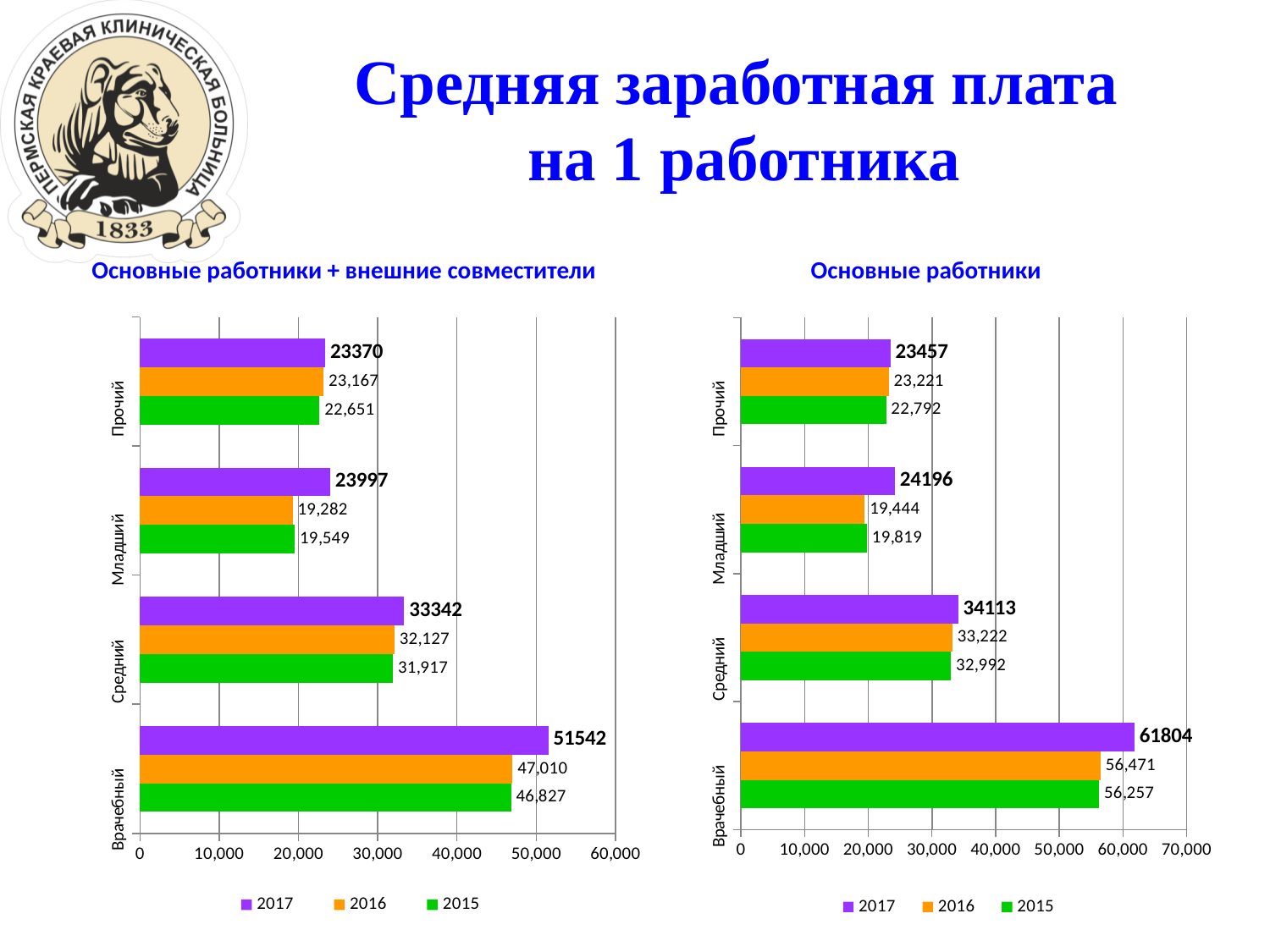
In the chart titled 'Основные работники', what is the value for Прочий in 2015? 22,792 In the chart titled 'Основные работники + внешние совместители', which category has the highest value in 2017? Врачебный How many series does the legend of the chart titled 'Основные работники + внешние совместители' list? 3 In the chart titled 'Основные работники + внешние совместители', what is the difference between the 2017 and 2016 values for Врачебный? 4532 In the chart titled 'Основные работники', which category has the lowest value in 2016? Младший In the chart titled 'Основные работники', is the 2017 value for Врачебный greater or less than 60,000? greater What kind of chart is the chart titled 'Основные работники'? bar chart How many categories are shown on the y axis of the chart titled 'Основные работники'? 4 In the chart titled 'Основные работники + внешние совместители', which is larger for Младший: the 2016 value or the 2015 value? 2015 In the chart titled 'Основные работники + внешние совместители', what is the value for Врачебный in 2017? 51542 In the chart titled 'Основные работники', what is the difference between the 2017 and 2015 values for Младший? 4377 In the chart titled 'Основные работники', what is the value for Средний in 2016? 33,222